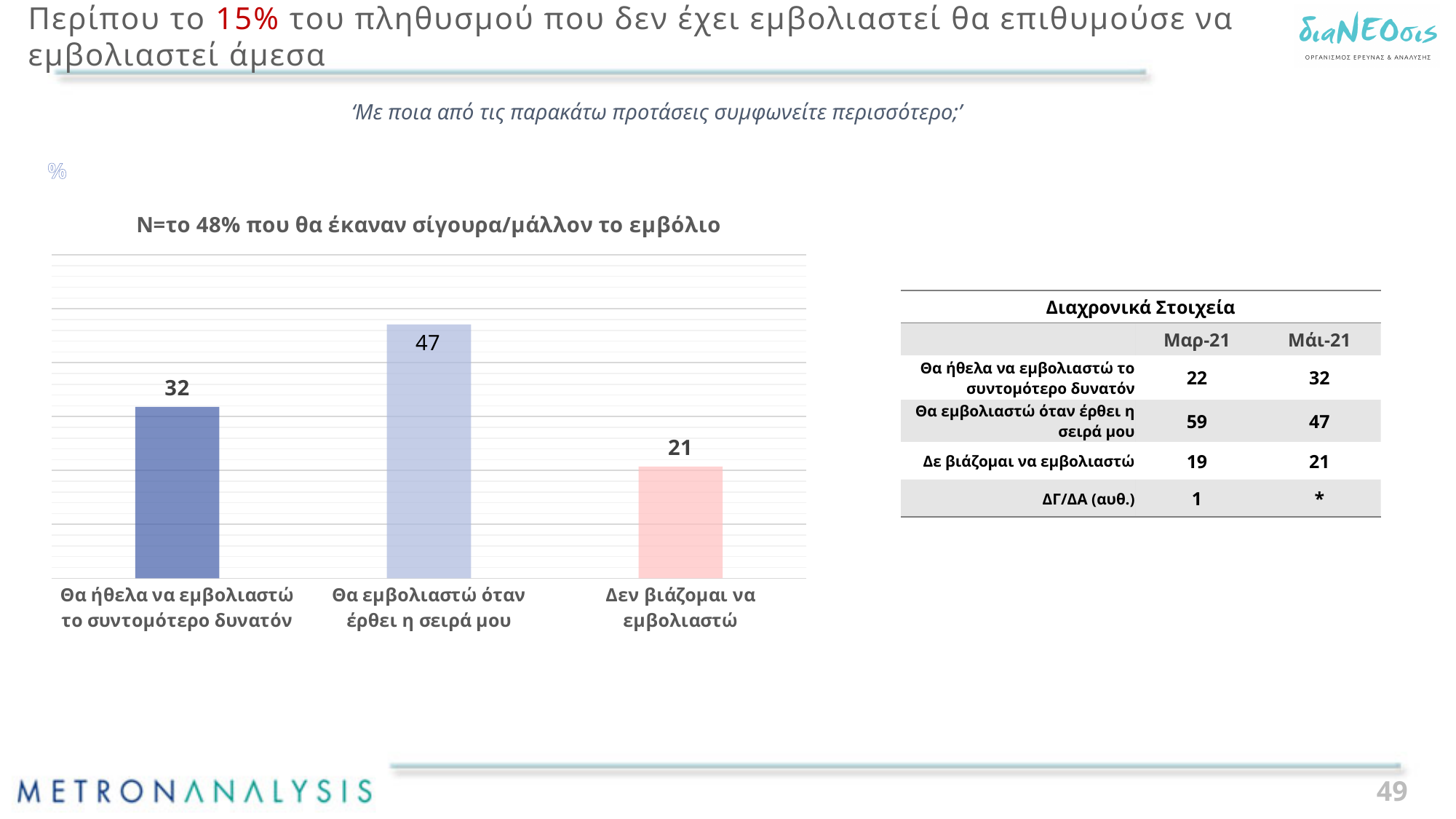
What value is shown for 'Θα εμβολιαστώ όταν έρθει η σειρά μου'? 47 How many categories are shown in the bar chart? 3 What colour is the bar for 'Δεν βιάζομαι να εμβολιαστώ'? Pink Which category has the lowest value in the bar chart? Δεν βιάζομαι να εμβολιαστώ Which category has the highest value in the bar chart? Θα εμβολιαστώ όταν έρθει η σειρά μου What value is shown for 'Δεν βιάζομαι να εμβολιαστώ'? 21 What kind of chart is shown on the slide? Bar chart What is the title of the bar chart? N=το 48% που θα έκαναν σίγουρα/μάλλον το εμβόλιο What is the difference between the values for 'Θα ήθελα να εμβολιαστώ το συντομότερο δυνατόν' and 'Δεν βιάζομαι να εμβολιαστώ'? 11 Which is larger: the value for 'Θα ήθελα να εμβολιαστώ το συντομότερο δυνατόν' or for 'Δεν βιάζομαι να εμβολιαστώ'? Θα ήθελα να εμβολιαστώ το συντομότερο δυνατόν What value is shown for 'Θα ήθελα να εμβολιαστώ το συντομότερο δυνατόν'? 32 What is the difference between the values for 'Θα εμβολιαστώ όταν έρθει η σειρά μου' and 'Θα ήθελα να εμβολιαστώ το συντομότερο δυνατόν'? 15